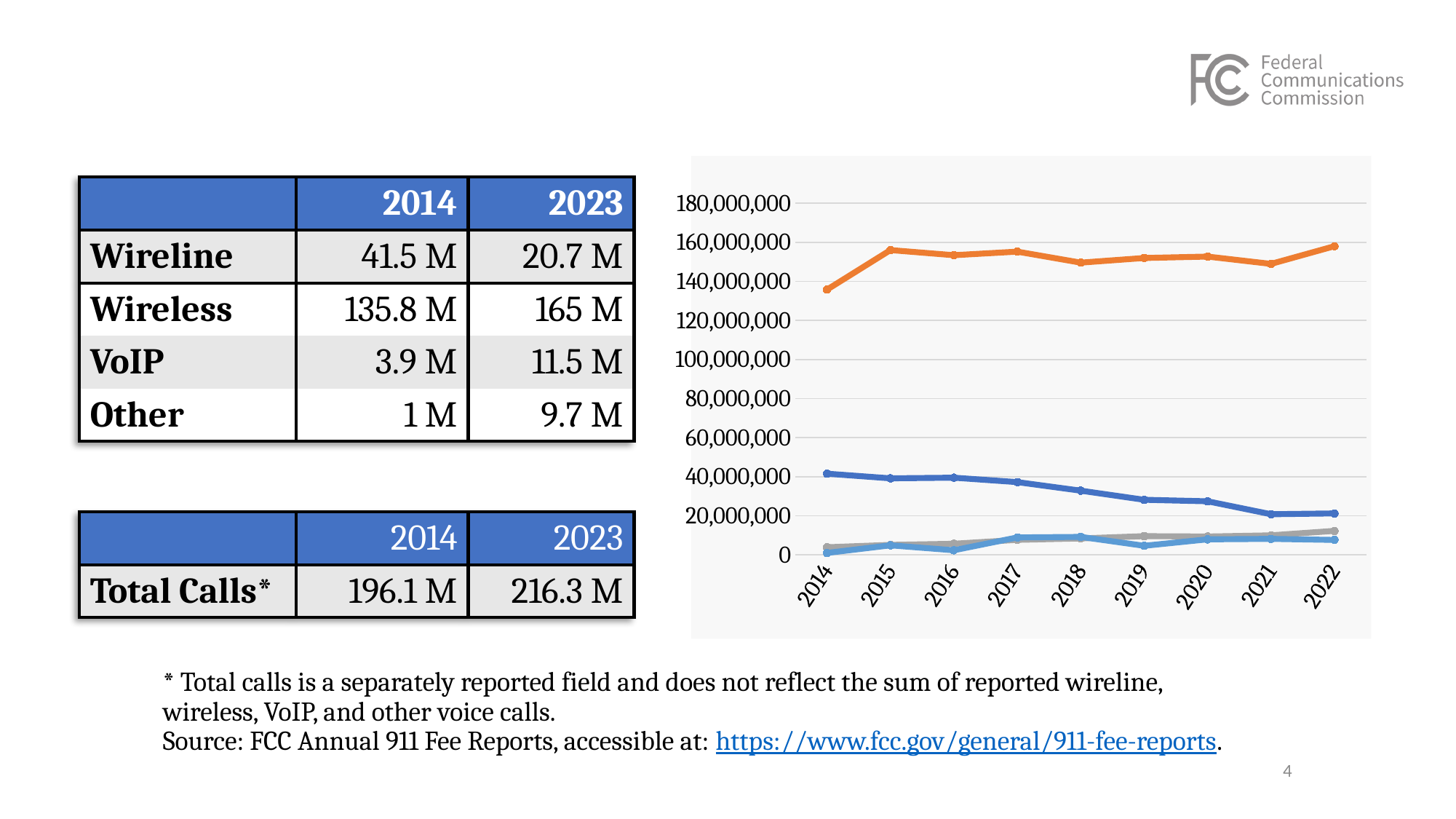
Which coloured line is highest across all years on the line chart? orange Is the value of the orange line in 2015 greater or less than 160,000,000? less Is the value of the dark blue line in 2018 greater or less than 40,000,000? less Is the value of the orange line in 2022 greater or less than 140,000,000? greater Does the dark blue line rise or fall from 2014 to 2022? fall What is the first year shown on the x axis of the line chart? 2014 How many lines are plotted on the line chart? 4 What is the last year shown on the x axis of the line chart? 2022 In 2014, which is larger on the line chart: the orange line or the dark blue line? orange line How many years are shown along the x axis of the line chart? 9 What kind of chart is shown on the right of the slide? line chart